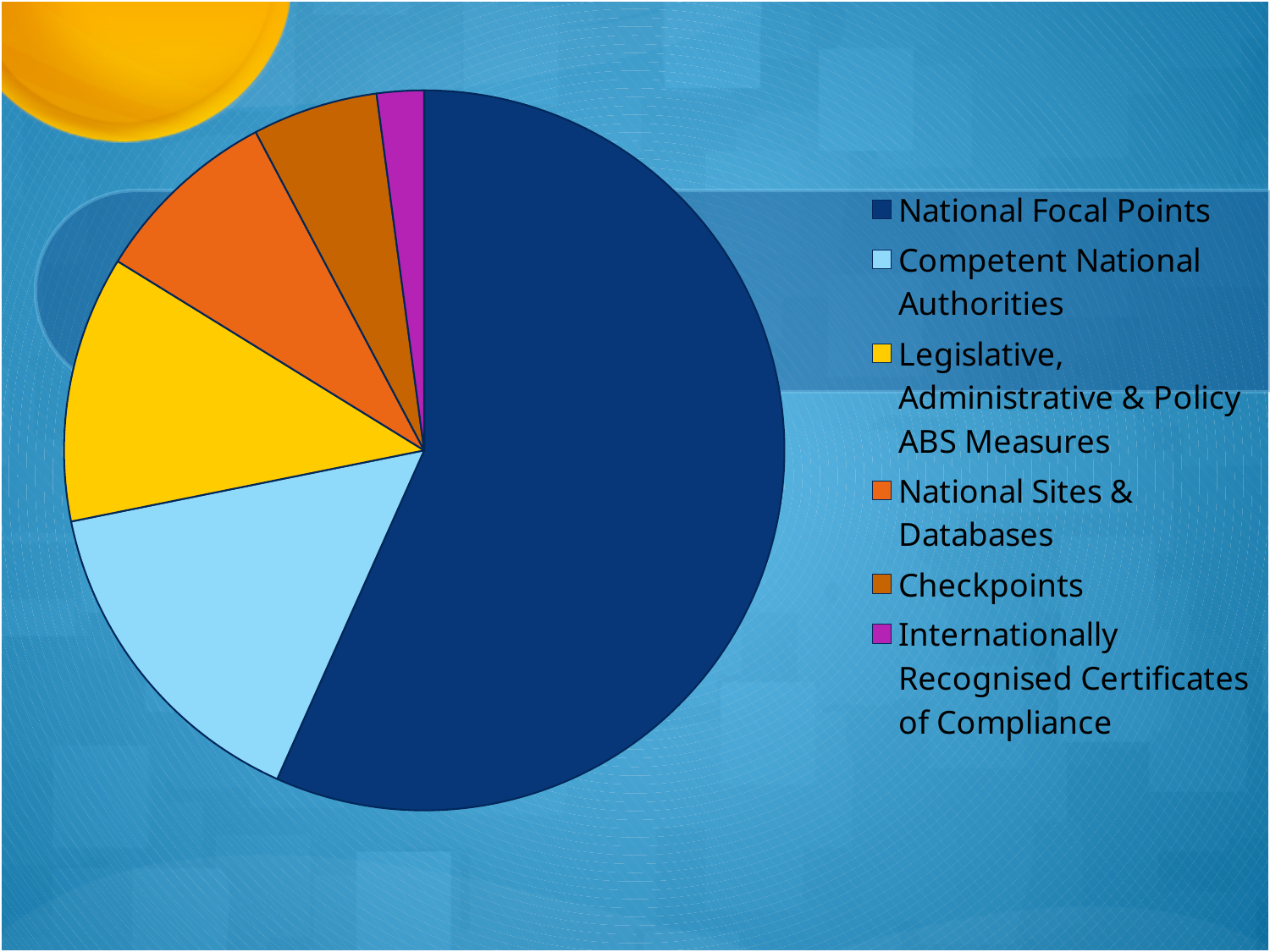
How many entries does the legend list? 6 How many slices does the pie chart have? 6 Which slice is larger: Legislative, Administrative & Policy ABS Measures or Checkpoints? Legislative, Administrative & Policy ABS Measures Which slice is larger: National Sites & Databases or Internationally Recognised Certificates of Compliance? National Sites & Databases Which slice is larger: Competent National Authorities or Checkpoints? Competent National Authorities What kind of chart is shown on the slide? pie chart What colour is the slice for National Focal Points? dark blue Which category is shown in purple? Internationally Recognised Certificates of Compliance Which category has the largest slice of the pie? National Focal Points Which category has the smallest slice of the pie? Internationally Recognised Certificates of Compliance